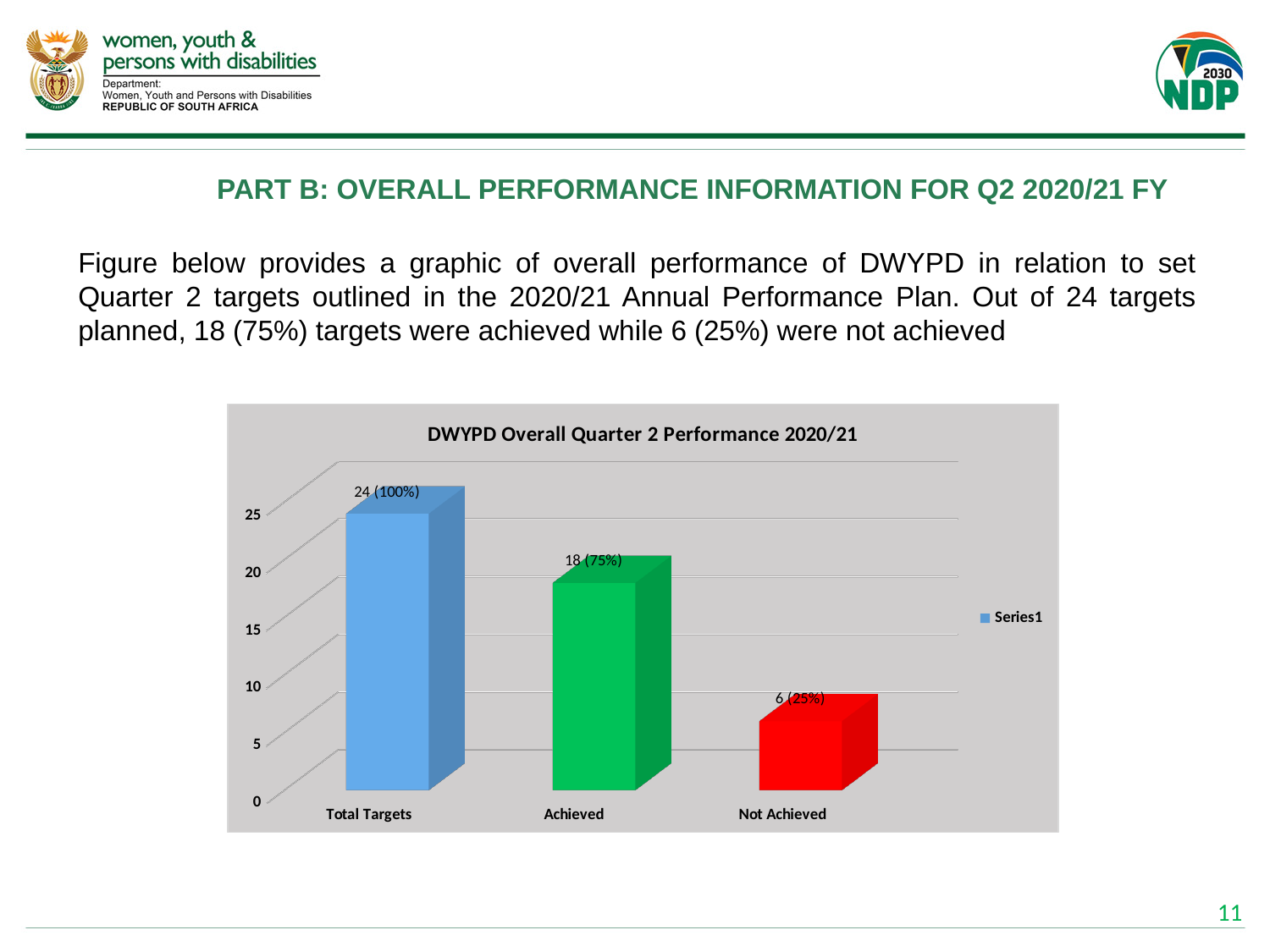
What is the value shown for Achieved? 18 (75%) What is the difference between the number of targets Achieved and Not Achieved? 12 What is the title of the chart? DWYPD Overall Quarter 2 Performance 2020/21 Which is larger, the value for Achieved or the value for Not Achieved? Achieved Which category has the highest value? Total Targets Which category has the lowest value? Not Achieved What is the value shown for Not Achieved? 6 (25%) How many series does the legend list? 1 Is the value for Achieved greater or less than 15? greater How many categories are shown on the x axis? 3 What kind of chart is shown on the slide? Bar chart What is the value shown for Total Targets? 24 (100%)